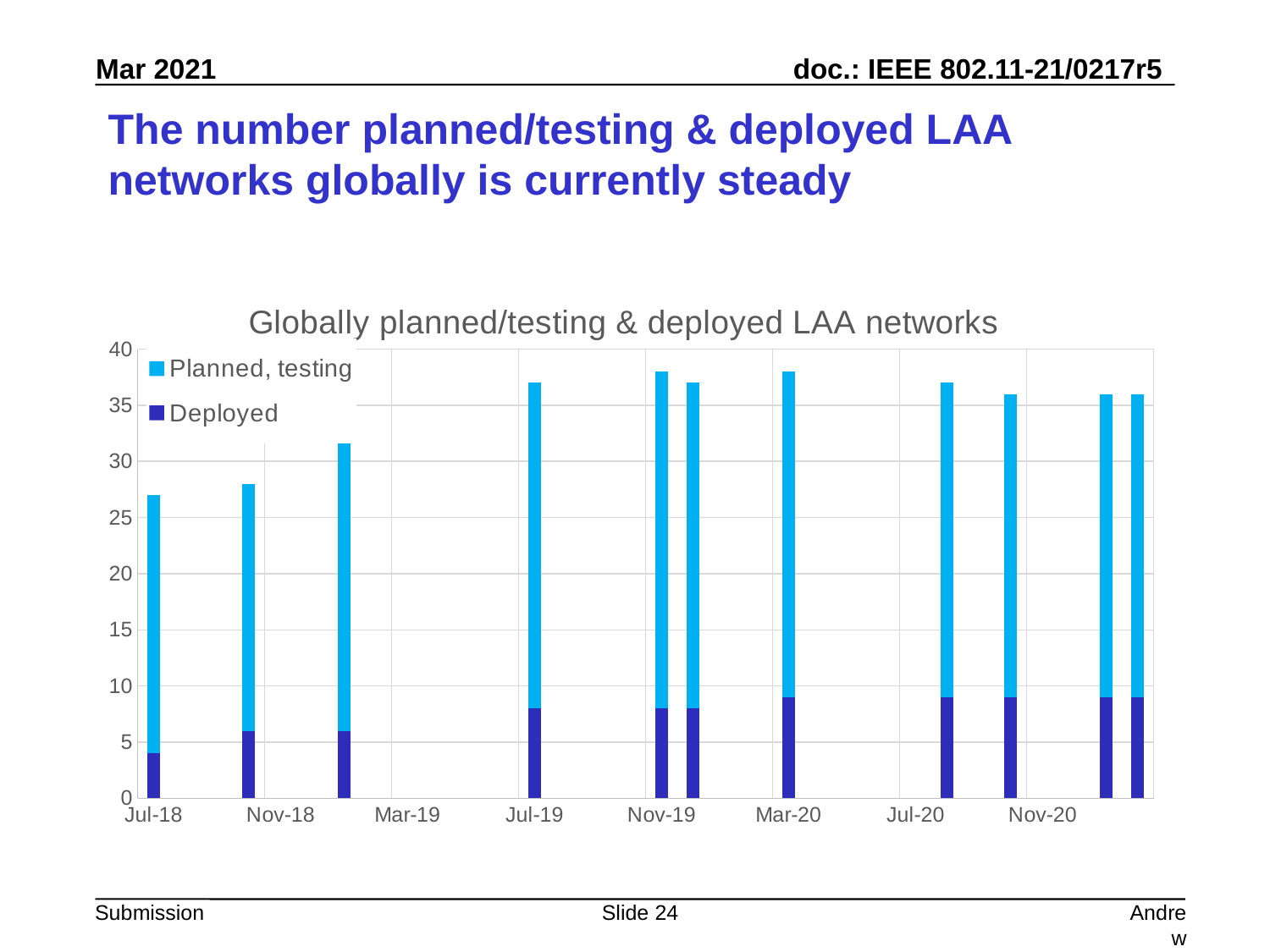
Is the total height of the bar at Nov-18 greater or less than 30? less How many bars are plotted in the chart? 11 What are the two series named in the legend? Planned, testing; Deployed What is the title of the chart? Globally planned/testing & deployed LAA networks Is the total height of the bar at Jul-18 greater or less than 30? less Is the total height of the bar at Jul-19 greater or less than 35? greater Do the total bar heights rise or fall from Jul-18 to Jul-19? rise What kind of chart is shown on the slide? Stacked bar chart How many series does the legend list? 2